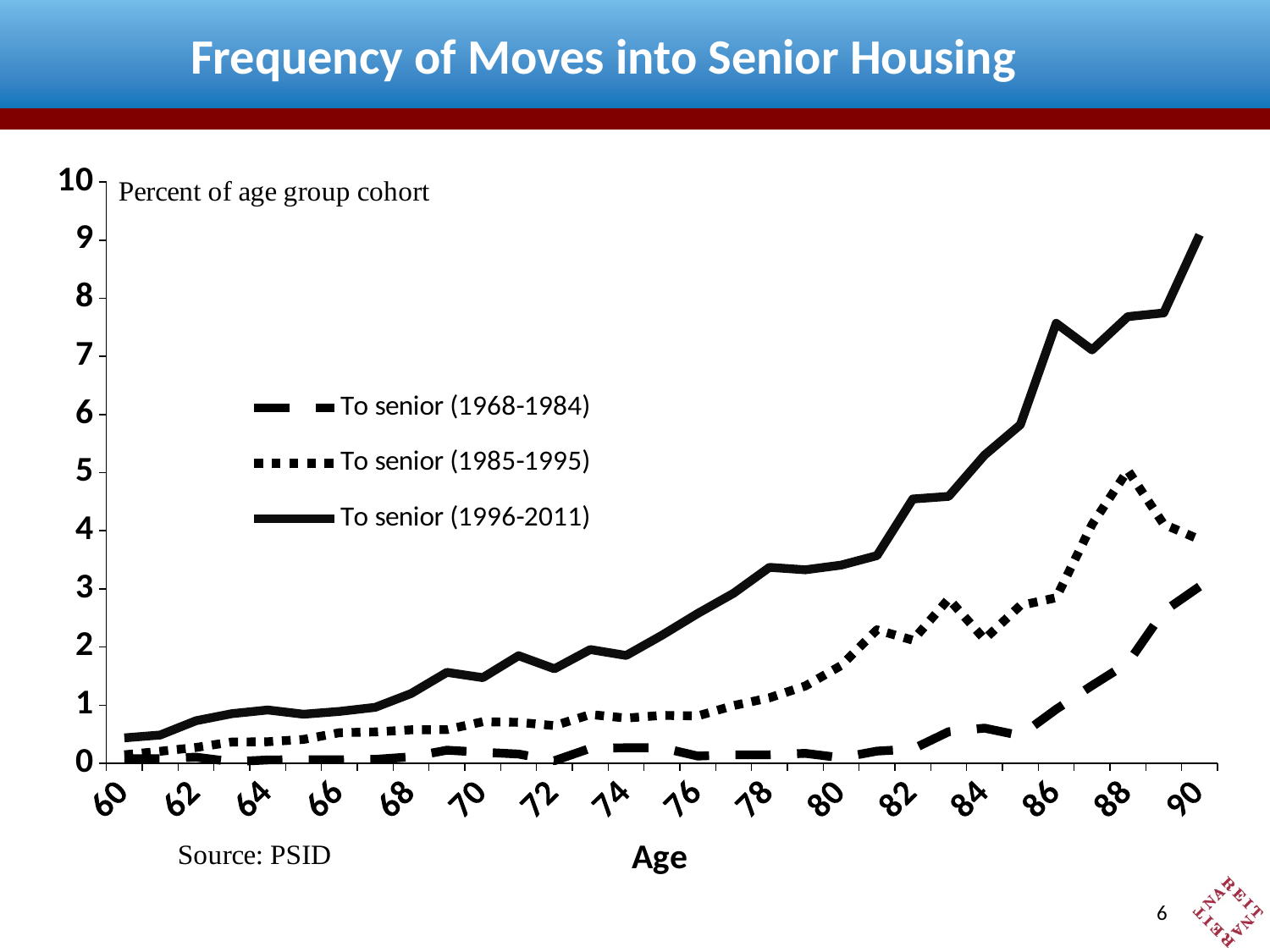
Does the To senior (1996-2011) series generally rise or fall as age increases from 60 to 90? rise What is the title of the chart? Frequency of Moves into Senior Housing Is the value for To senior (1996-2011) at age 80 greater or less than 3? greater How many series does the legend list? 3 How many age labels are shown on the x axis? 16 Which series has the lowest value at age 90? To senior (1968-1984) Which series has the highest value at age 90? To senior (1996-2011) Is the value for To senior (1996-2011) at age 90 greater or less than 8? greater What kind of chart is shown on the slide? line chart At age 80, which series has the larger value: To senior (1996-2011) or To senior (1985-1995)? To senior (1996-2011) Which series is drawn with a solid line? To senior (1996-2011)